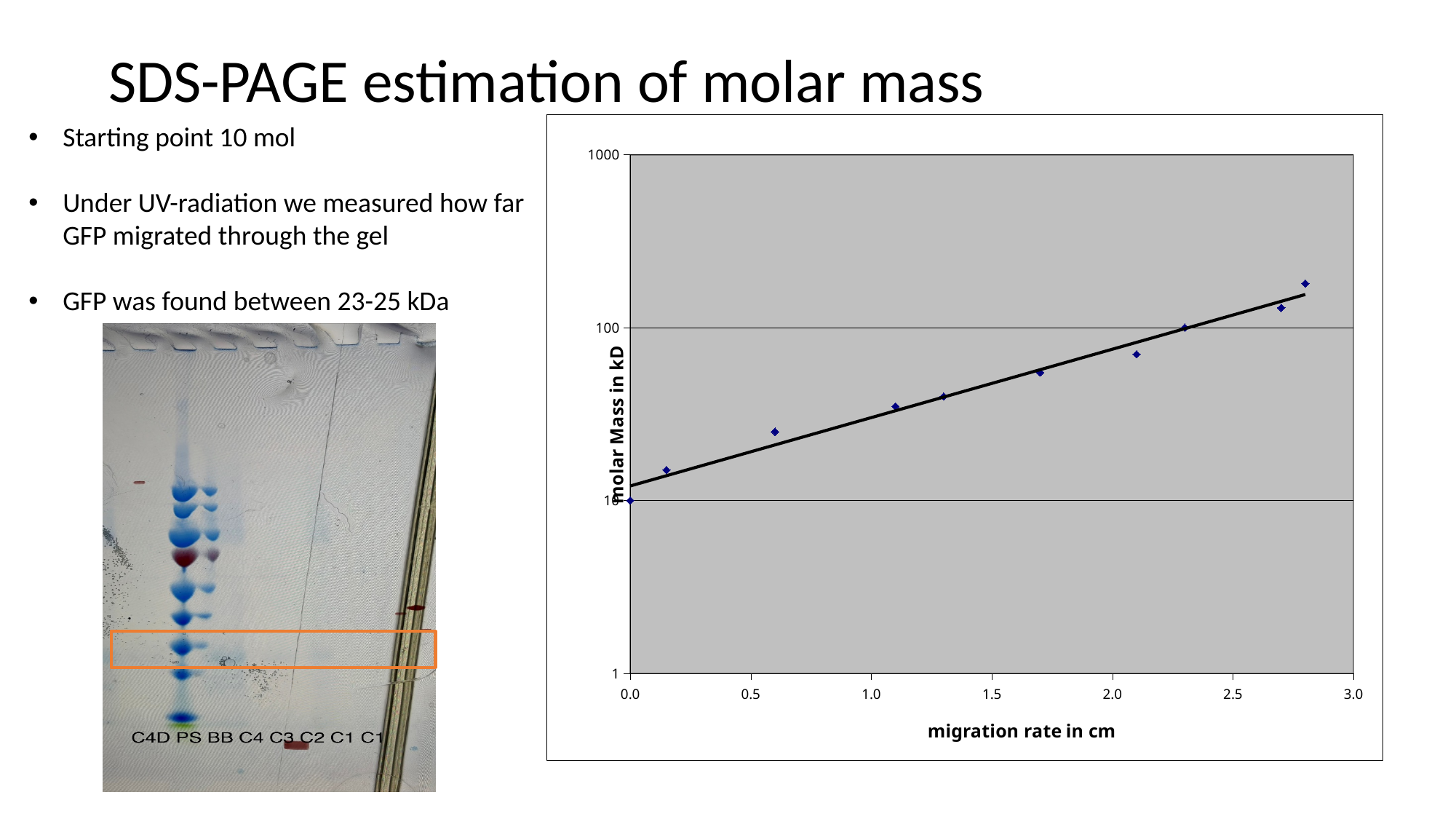
What is the label of the x axis of the chart? migration rate in cm What molar mass is plotted at a migration rate of 0.0 cm? 10 Is the molar mass plotted at a migration rate of 1.1 cm greater or less than 100? less Which is larger: the molar mass plotted at 2.1 cm or at 1.3 cm? 2.1 cm What kind of chart is shown on the slide? scatter chart What is the label of the y axis of the chart? molar Mass in kD Is the molar mass plotted at a migration rate of 2.8 cm greater or less than 100? greater At which migration rate is the plotted molar mass highest? 2.8 What molar mass is plotted at a migration rate of 2.3 cm? 100 Is the molar mass plotted at a migration rate of 0.6 cm greater or less than 10? greater Do the plotted molar mass values rise or fall as the migration rate increases? rise How many data points are plotted in the chart? 10